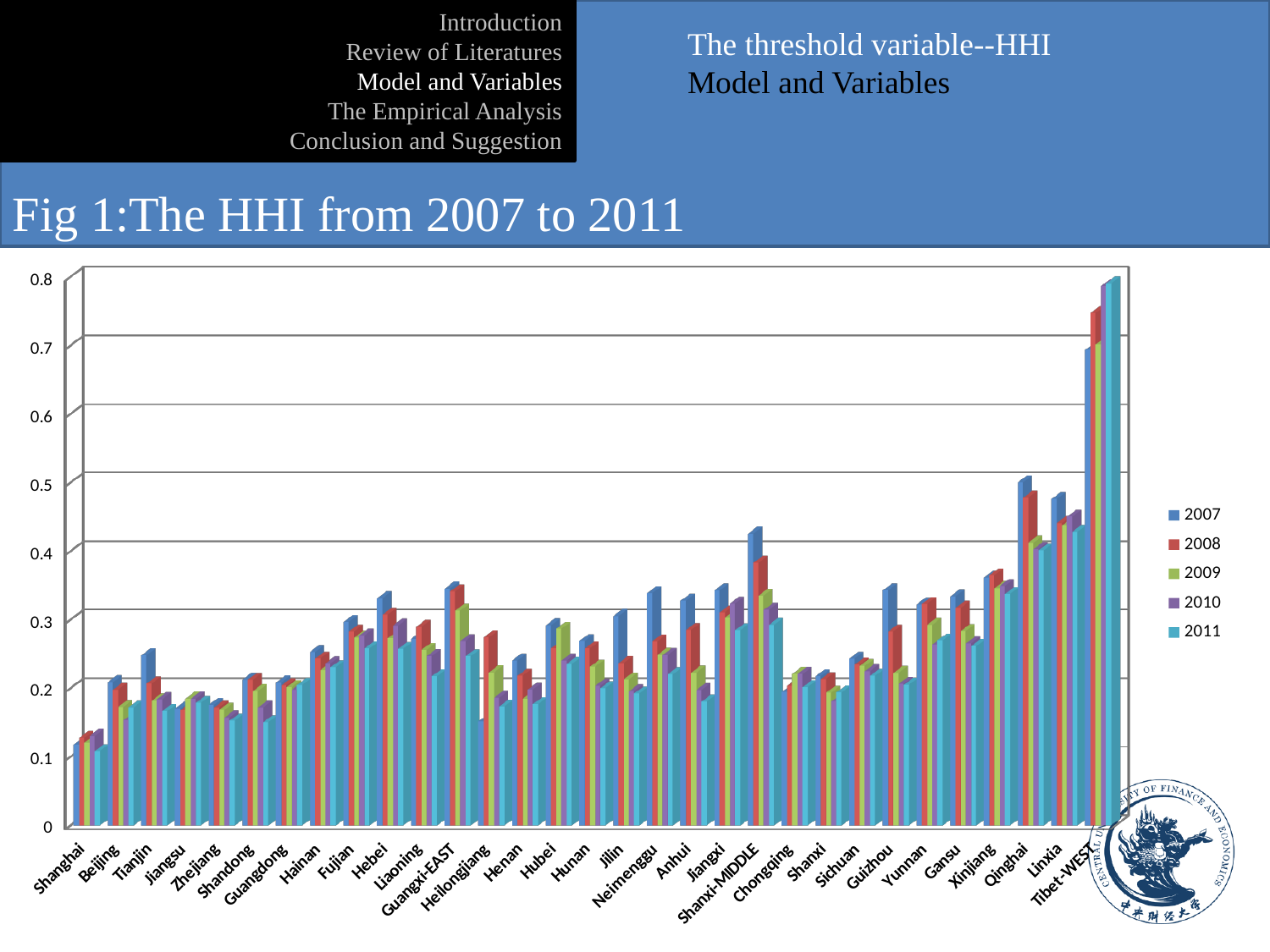
What kind of chart is shown on the slide? bar chart How many provinces (categories) are shown on the x axis? 31 Which has the larger 2007 value, Shanxi-MIDDLE or Chongqing? Shanxi-MIDDLE Which province has the lowest HHI values in the chart? Shanghai Is the 2007 value for Shanxi-MIDDLE greater or less than 0.4? greater Which province has the highest HHI values in the chart? Tibet-WEST Is the 2011 value for Tibet-WEST greater or less than 0.7? greater How many series does the legend list? 5 Is the 2007 value for Shanghai greater or less than 0.2? less Which years are listed in the legend? 2007, 2008, 2009, 2010, 2011 What is the title of the chart? Fig 1:The HHI from 2007 to 2011 For Shanxi-MIDDLE, do the values rise or fall from 2007 to 2011? fall